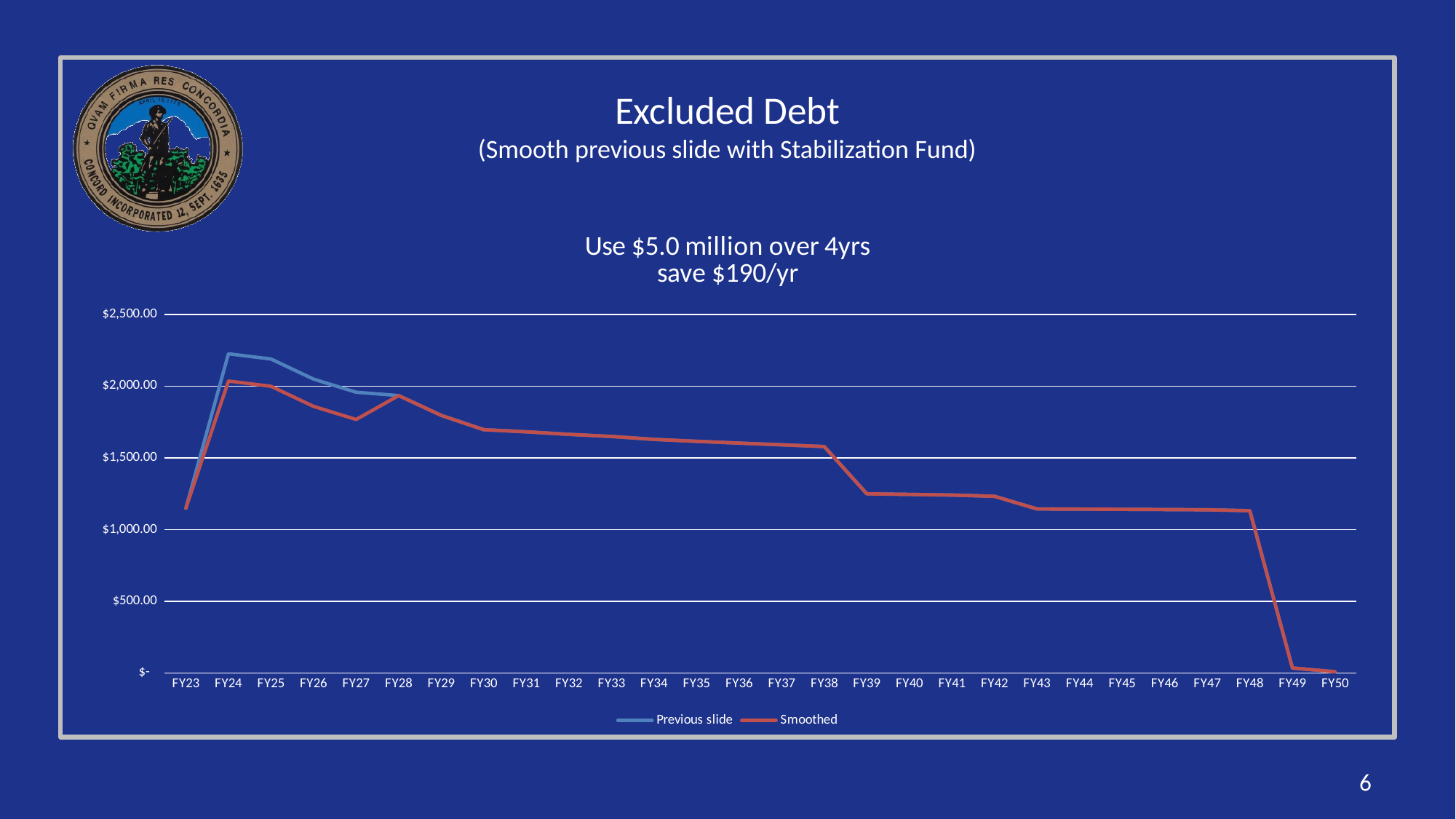
Is the value of the Smoothed series at FY39 greater or less than $1,000.00? greater How many fiscal years are plotted along the x axis? 28 Is the value of the Smoothed series at FY49 greater or less than $500.00? less What is the title printed above the chart? Use $5.0 million over 4yrs save $190/yr What kind of chart is shown on the slide? Line chart At FY24, which series has the higher value, Previous slide or Smoothed? Previous slide In which fiscal year does the Previous slide series reach its highest value? FY24 Is the value of the Smoothed series at FY27 greater or less than $2,000.00? less What are the names of the two series in the legend? Previous slide and Smoothed Do the Smoothed series values rise or fall from FY28 to FY38? Fall How many series does the chart legend list? 2